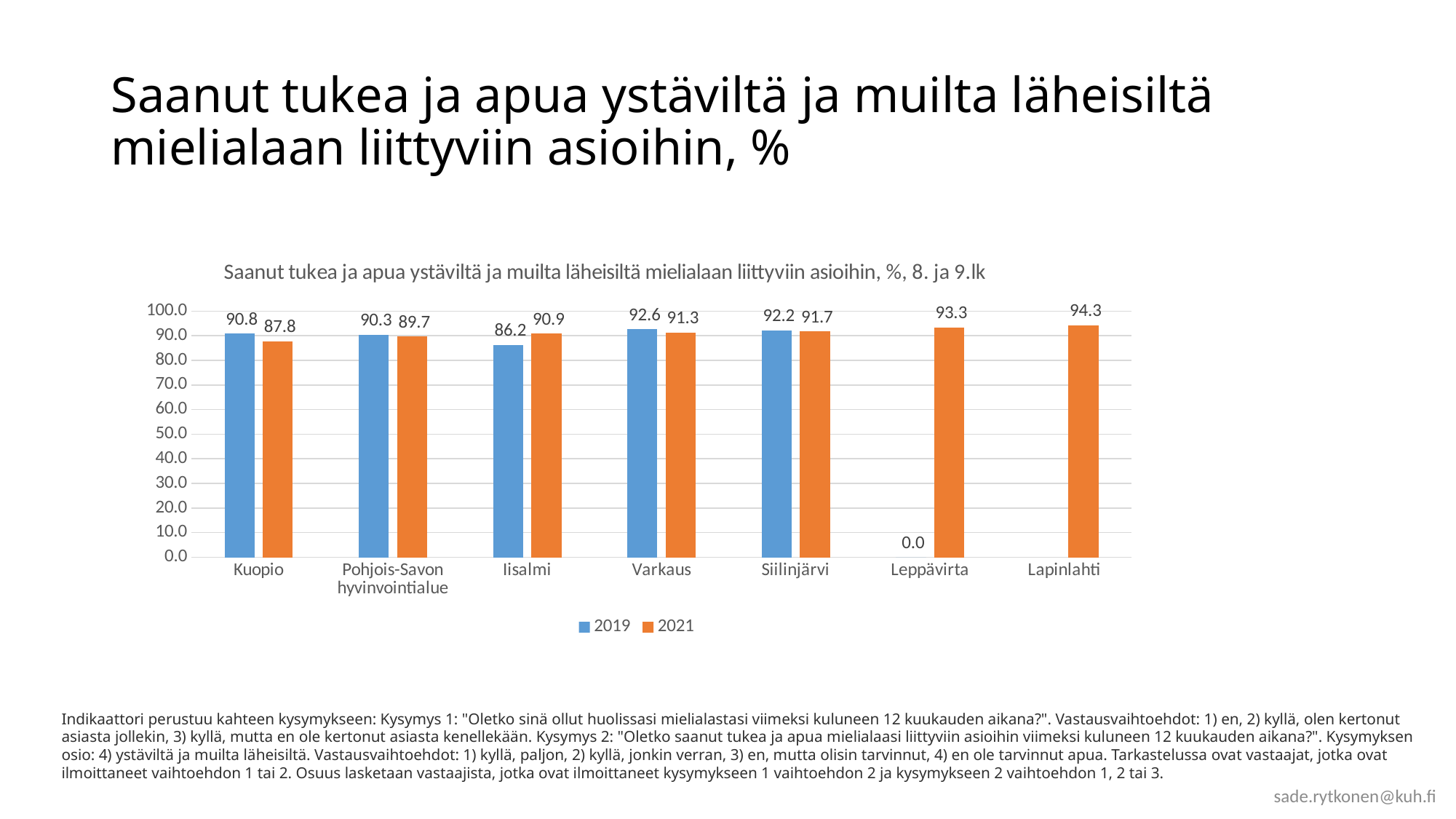
What is the difference between the 2021 and 2019 values for Iisalmi? 4.7 What is the 2021 value for Iisalmi? 90.9 Which category has the highest 2021 value? Lapinlahti What is the 2019 value for Kuopio? 90.8 How many series does the legend list? 2 Which is larger for Varkaus, the 2019 value or the 2021 value? 2019 What is the 2021 value for Lapinlahti? 94.3 How many categories are shown on the x axis? 7 What kind of chart is shown on the slide? Bar chart What is the 2019 value for Leppävirta? 0.0 What is the difference between the 2019 and 2021 values for Kuopio? 3.0 Which category has the lowest 2021 value? Kuopio